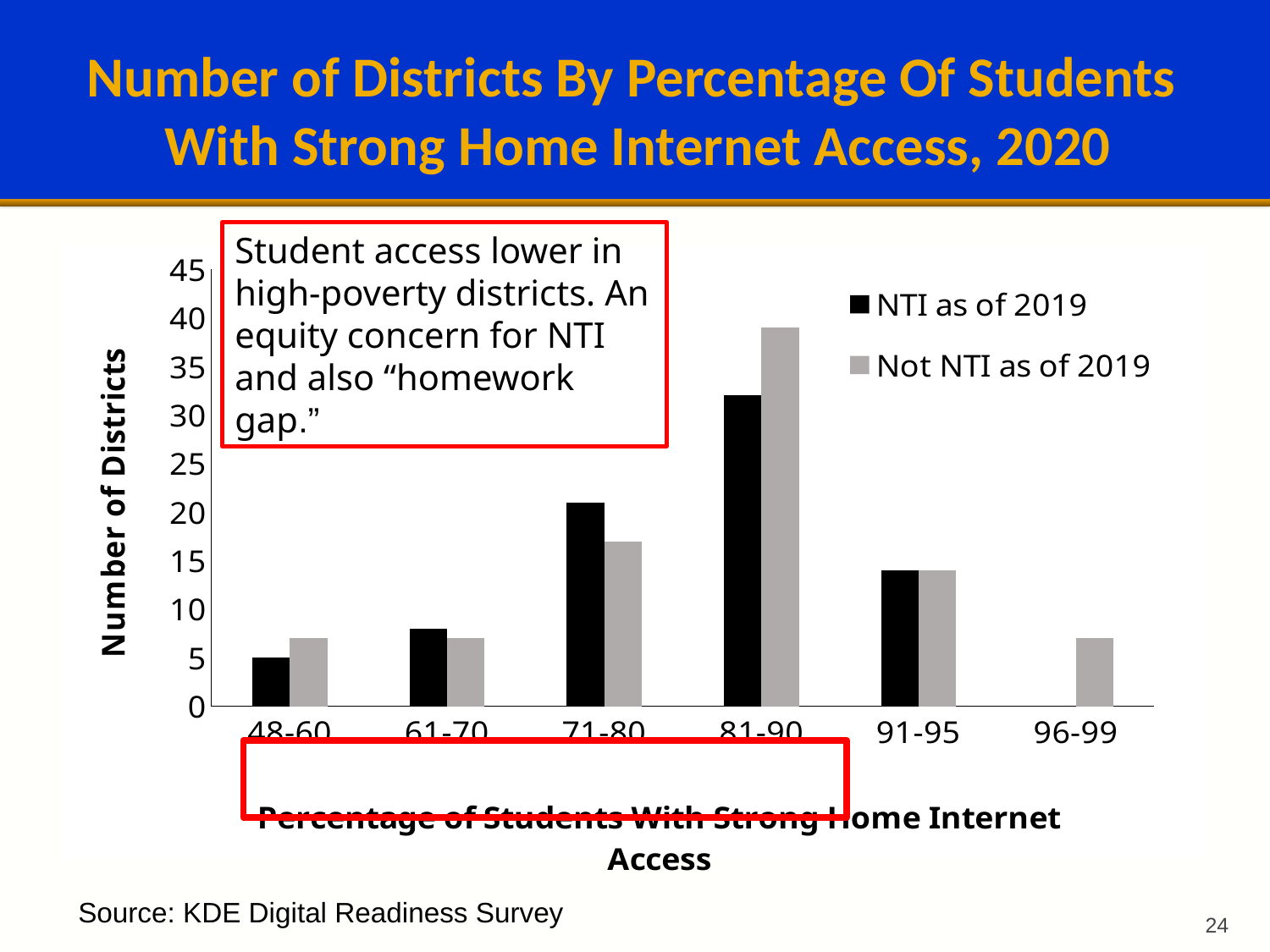
Which percentage range has the highest number of districts for the 'Not NTI as of 2019' series? 81-90 Is the number of 'NTI as of 2019' districts in the 81-90 range greater or less than 30? greater In the 71-80 range, which series has more districts, 'NTI as of 2019' or 'Not NTI as of 2019'? NTI as of 2019 What is the label on the vertical axis of the chart? Number of Districts What kind of chart is shown on the slide? bar chart How many percentage ranges are shown along the x axis? 6 In the 81-90 range, which series has more districts, 'NTI as of 2019' or 'Not NTI as of 2019'? Not NTI as of 2019 Is the number of 'NTI as of 2019' districts in the 48-60 range greater or less than 10? less Is the number of 'Not NTI as of 2019' districts in the 81-90 range greater or less than 35? greater How many series does the legend list? 2 Which percentage range has the highest number of districts for the 'NTI as of 2019' series? 81-90